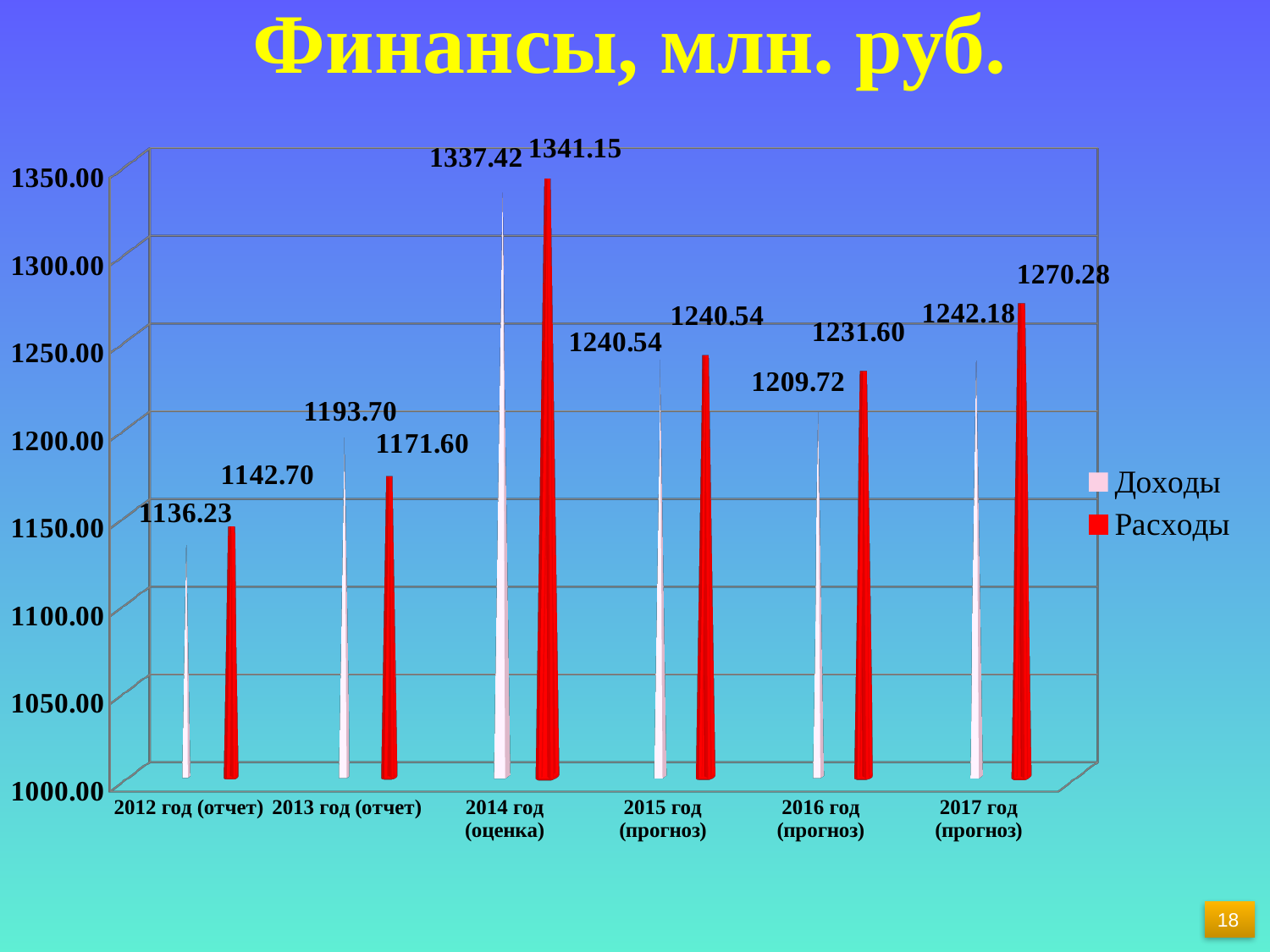
For 2013 год (отчет), which is larger: Доходы or Расходы? Доходы What is the difference between Доходы and Расходы for 2013 год (отчет)? 22.10 How many series does the legend list? 2 In which year is Расходы the highest? 2014 год (оценка) What type of chart is shown on the slide? Bar chart What is the value of Доходы for 2012 год (отчет)? 1136.23 What is the value of Доходы for 2014 год (оценка)? 1337.42 In which year is Доходы the lowest? 2012 год (отчет) What is the difference between Расходы and Доходы for 2017 год (прогноз)? 28.10 How many year categories are shown on the x axis? 6 What is the value of Расходы for 2016 год (прогноз)? 1231.60 What is the value of Расходы for 2017 год (прогноз)? 1270.28